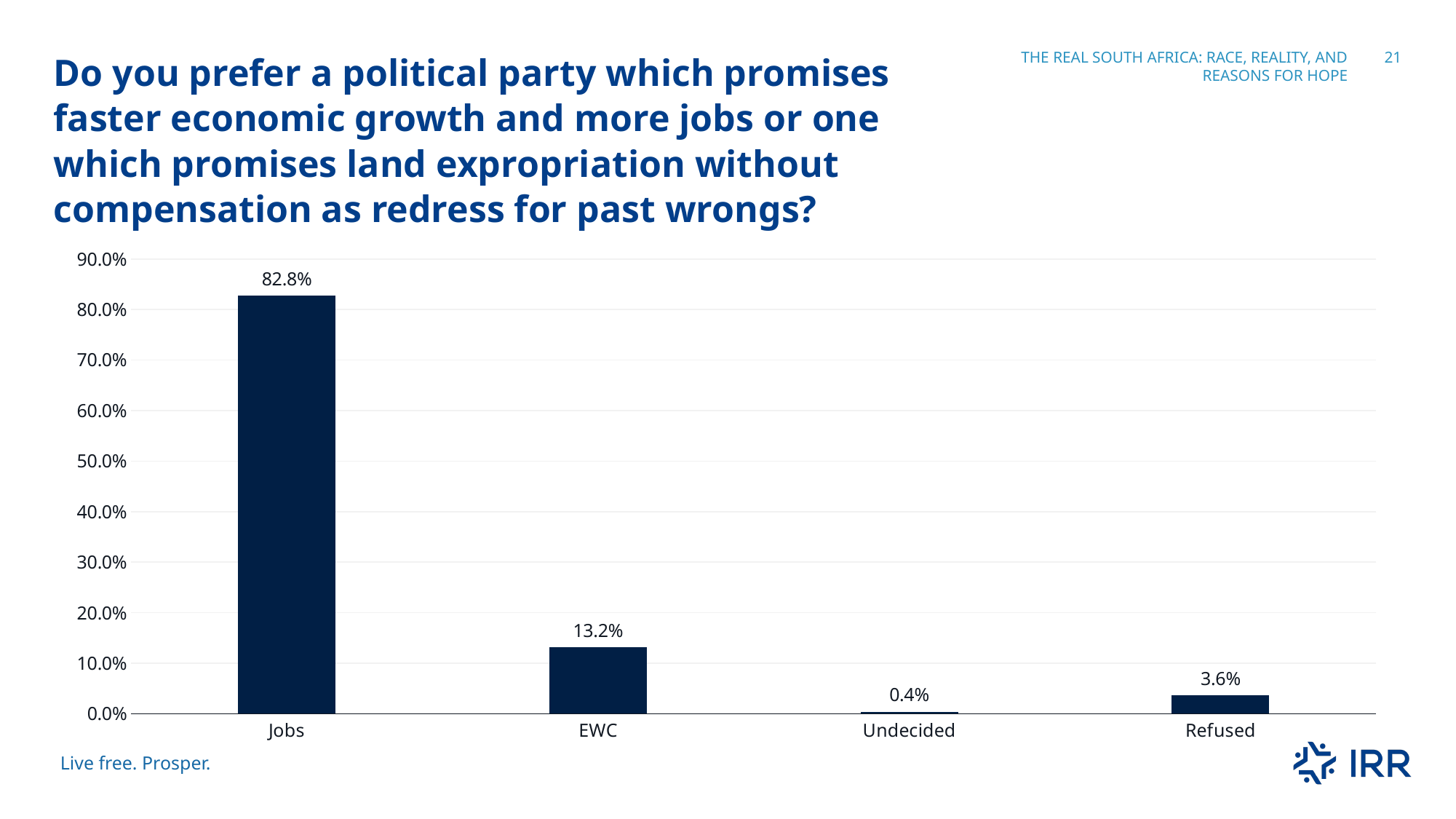
What is the value for Refused? 3.6% What percentage of respondents chose Jobs? 82.8% What kind of chart is shown on the slide? Bar chart Which is larger, the value for EWC or the value for Refused? EWC What is the difference between the Jobs and EWC values? 69.6% Is the value for EWC greater or less than 10.0%? greater What is the difference between the Refused and Undecided values? 3.2% What percentage of respondents were Undecided? 0.4% Which category has the lowest value? Undecided What is the value shown for EWC? 13.2% How many categories are shown on the x axis? 4 Which category has the highest value? Jobs